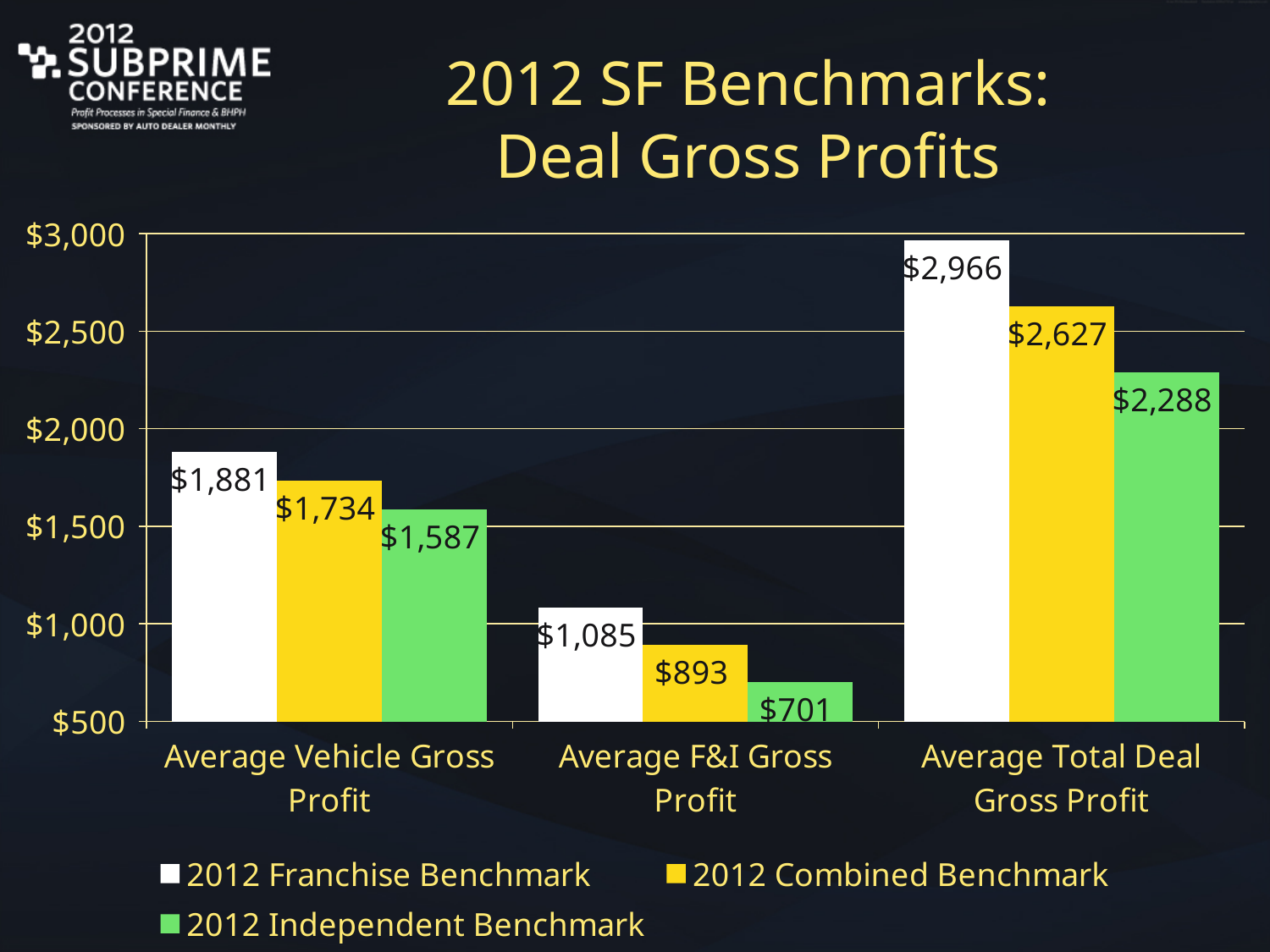
What is the 2012 Franchise Benchmark value for Average Vehicle Gross Profit? $1,881 Is the 2012 Combined Benchmark value for Average Total Deal Gross Profit greater or less than $2,500? greater What is the 2012 Combined Benchmark value for Average Total Deal Gross Profit? $2,627 Which category has the highest 2012 Franchise Benchmark value? Average Total Deal Gross Profit How many series does the legend list? 3 What is the difference between the 2012 Franchise Benchmark and the 2012 Independent Benchmark for Average Total Deal Gross Profit? $678 Which is larger for Average F&I Gross Profit: the 2012 Franchise Benchmark or the 2012 Combined Benchmark? 2012 Franchise Benchmark What is the difference between the 2012 Franchise Benchmark and the 2012 Combined Benchmark for Average Vehicle Gross Profit? $147 How many categories are shown on the x axis? 3 Which category has the lowest 2012 Independent Benchmark value? Average F&I Gross Profit What kind of chart is shown on the slide? Bar chart What is the 2012 Independent Benchmark value for Average F&I Gross Profit? $701